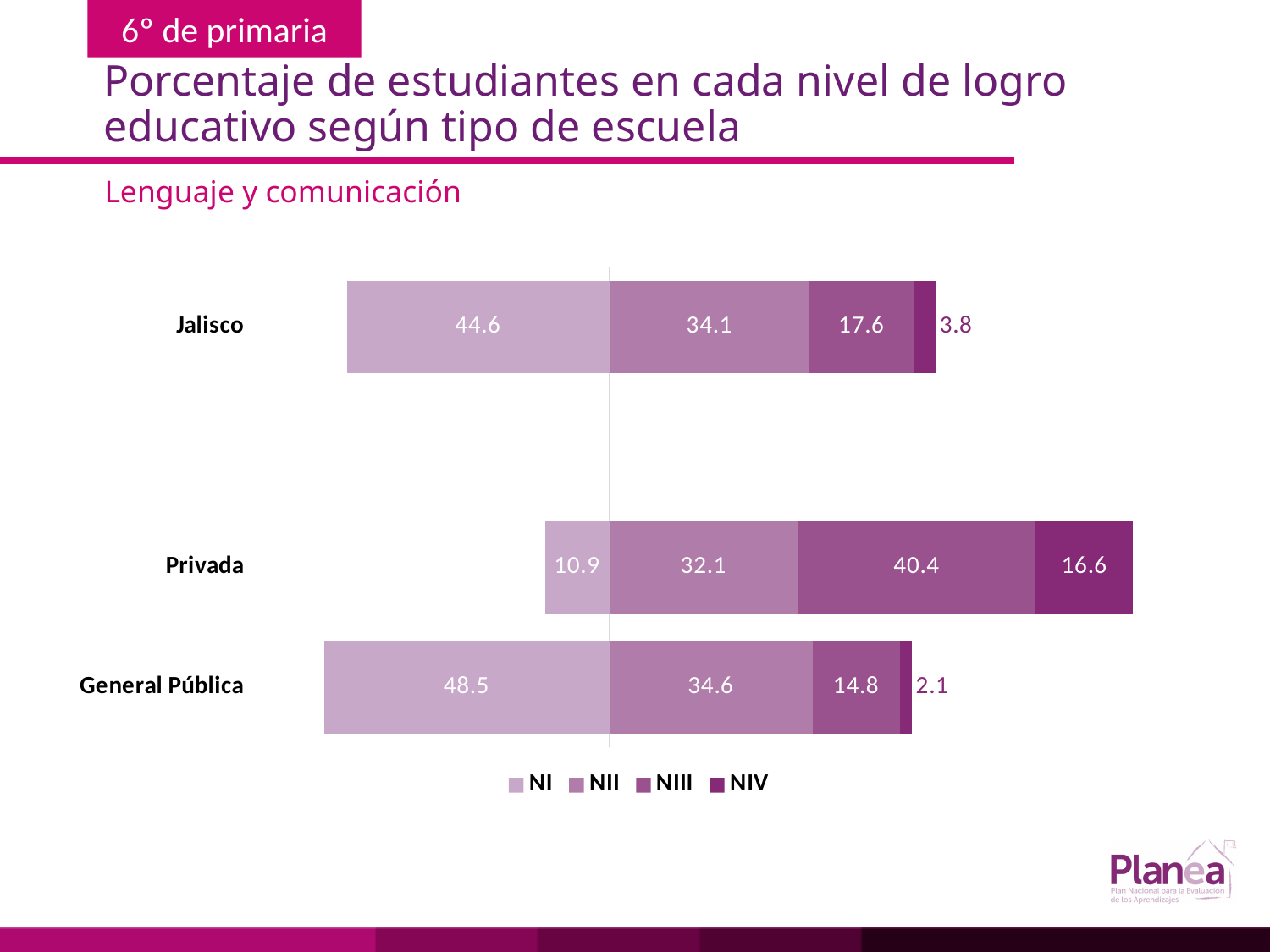
Which is larger, the NII value for General Pública or the NII value for Privada? General Pública What is the difference between the NIV values for Privada and Jalisco? 12.8 What subject is named in the subtitle above the chart? Lenguaje y comunicación How many series does the legend list? 4 What is the NIII value for Privada? 40.4 What is the NIV value for General Pública? 2.1 Which category has the lowest NIV value? General Pública What is the NI value for Jalisco? 44.6 What is the total of the stacked bar for Privada? 100.0 What type of chart is shown on the slide? Stacked bar chart How many categories (school types) are shown in the chart? 3 Which category has the highest NI value? General Pública